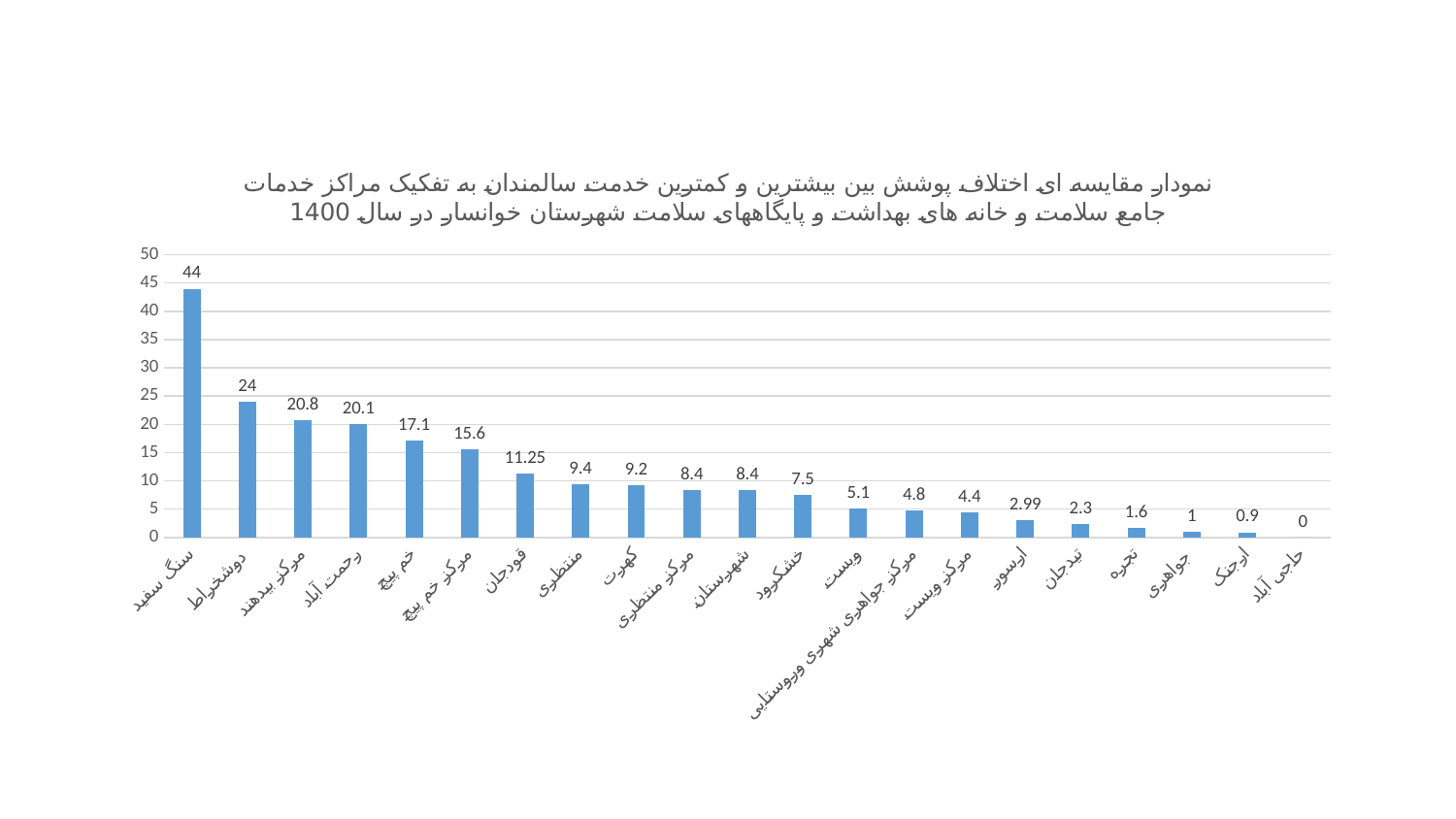
Do the values rise or fall from left to right along the x axis? fall What is the difference between the values for خم پیچ and مرکز خم پیچ? 1.5 Which category has the lowest value? حاجی آباد Which category has the highest value? سنگ سفید Is the value for مرکز بیدهند greater or less than 20? greater What is the value for سنگ سفید? 44 What is the difference between the values for سنگ سفید and دوشخراط? 20 What type of chart is shown on the slide? bar chart What is the value for ارسود? 2.99 How many categories are shown on the x axis? 21 Which is larger, the value for منتظری or the value for کهرت? منتظری What is the value for قودجان? 11.25